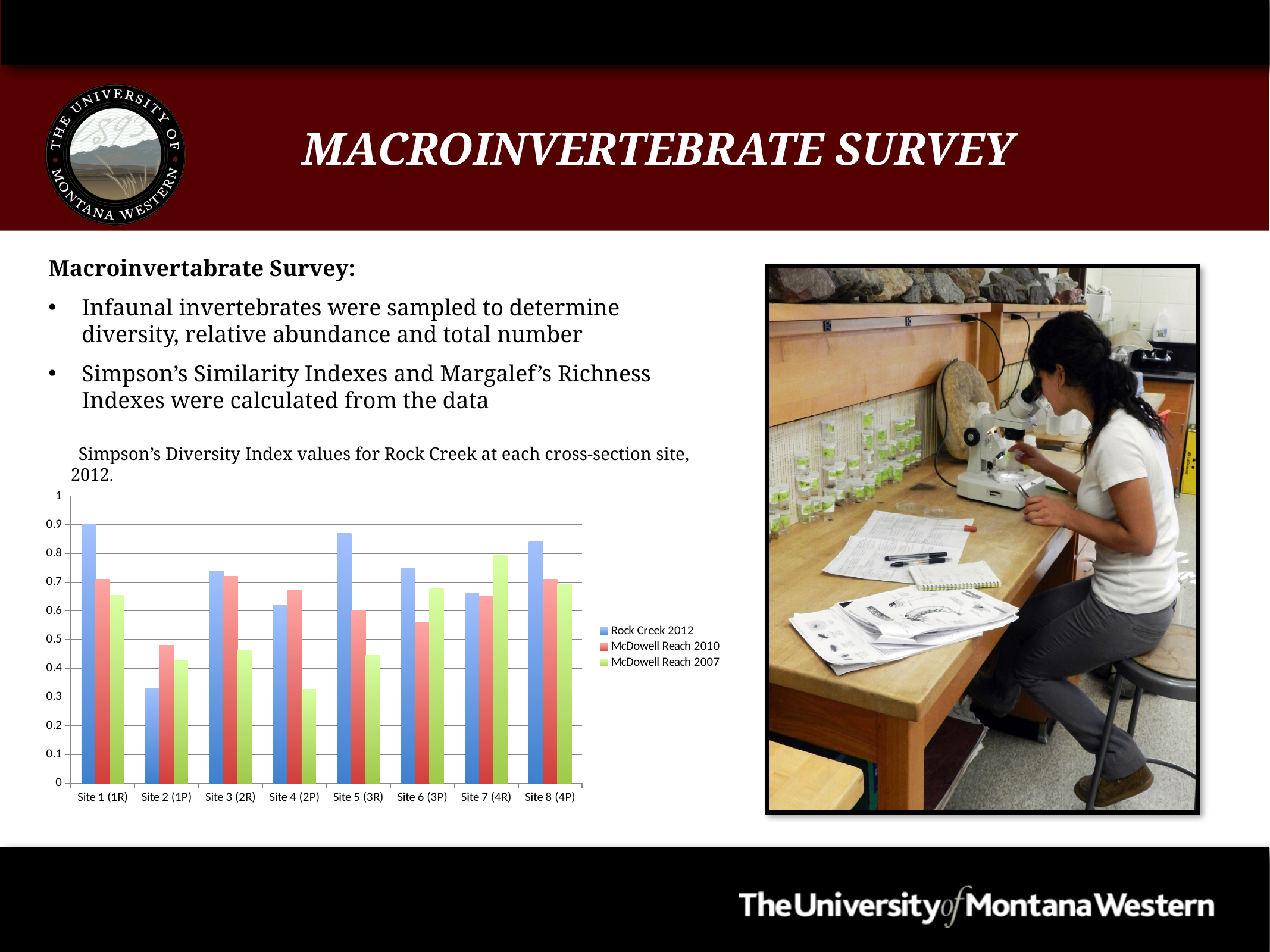
At Site 6 (3P), which is larger: the Rock Creek 2012 value or the McDowell Reach 2010 value? Rock Creek 2012 Is the Rock Creek 2012 value for Site 5 (3R) greater or less than 0.8? greater Which site has the lowest Rock Creek 2012 value? Site 2 (1P) Is the McDowell Reach 2007 value for Site 7 (4R) greater or less than 0.7? greater How many sites are shown along the x axis of the chart? 8 Which site has the highest McDowell Reach 2007 value? Site 7 (4R) How many series does the chart legend list? 3 What kind of chart is shown on the slide? bar chart Is the Rock Creek 2012 value for Site 2 (1P) greater or less than 0.4? less Which site has the lowest McDowell Reach 2007 value? Site 4 (2P) What colour are the Rock Creek 2012 bars in the chart? blue Which site has the lowest McDowell Reach 2010 value? Site 2 (1P)